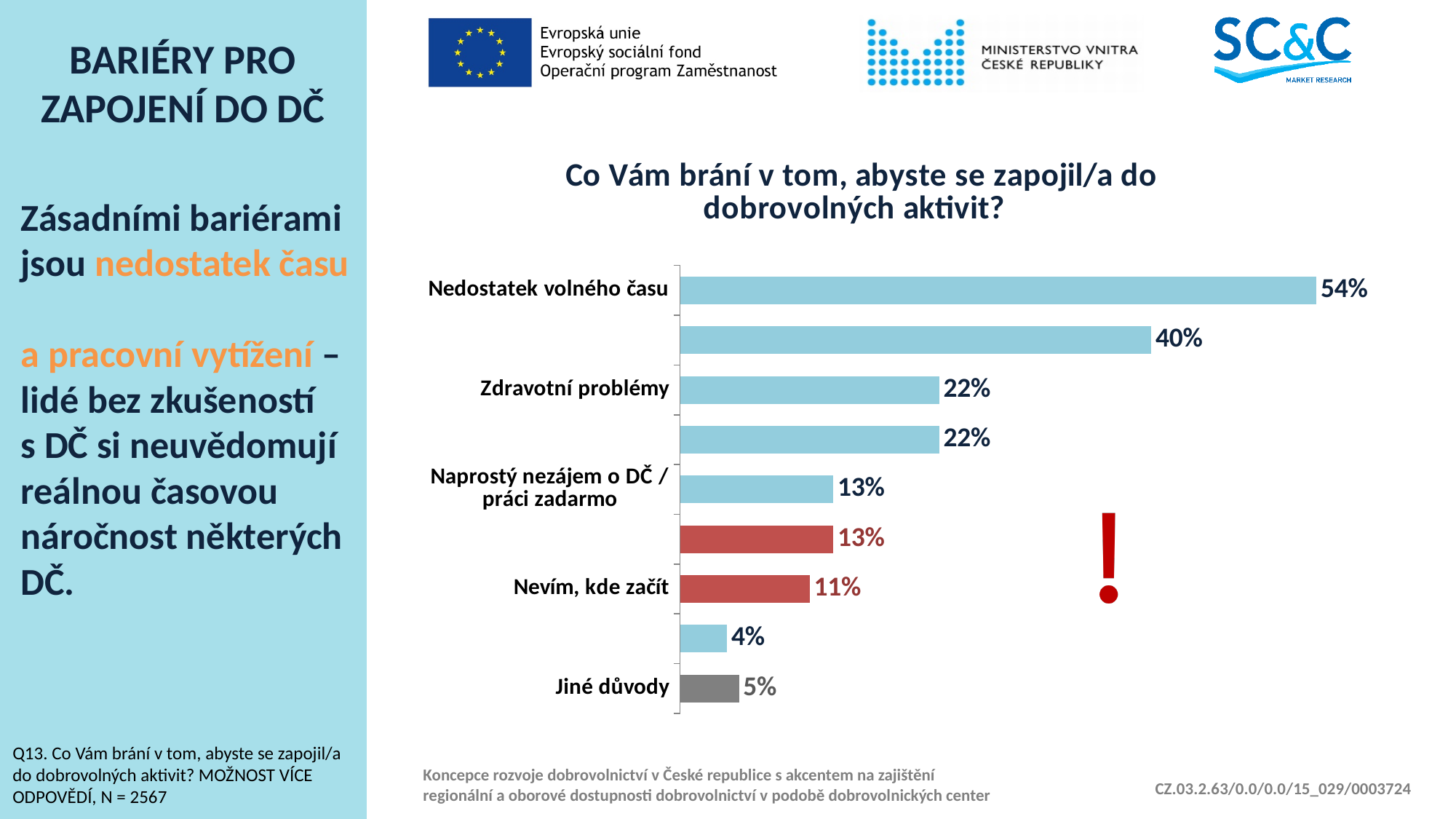
What is the value for "Nevím, kde začít"? 11% What is the value for "Nedostatek volného času"? 54% What is the value for "Jiné důvody"? 5% Which category has the highest value? Nedostatek volného času Which is larger, the value for "Zdravotní problémy" or for "Nevím, kde začít"? Zdravotní problémy What kind of chart is shown? Bar chart What is the difference between the values for "Nedostatek volného času" and "Zdravotní problémy"? 32 percentage points What is the value for "Naprostý nezájem o DČ / práci zadarmo"? 13% What is the value for "Zdravotní problémy"? 22% How many bars are plotted in the chart? 9 What colour is the bar for "Nevím, kde začít"? Red What is the title of the chart? Co Vám brání v tom, abyste se zapojil/a do dobrovolných aktivit?